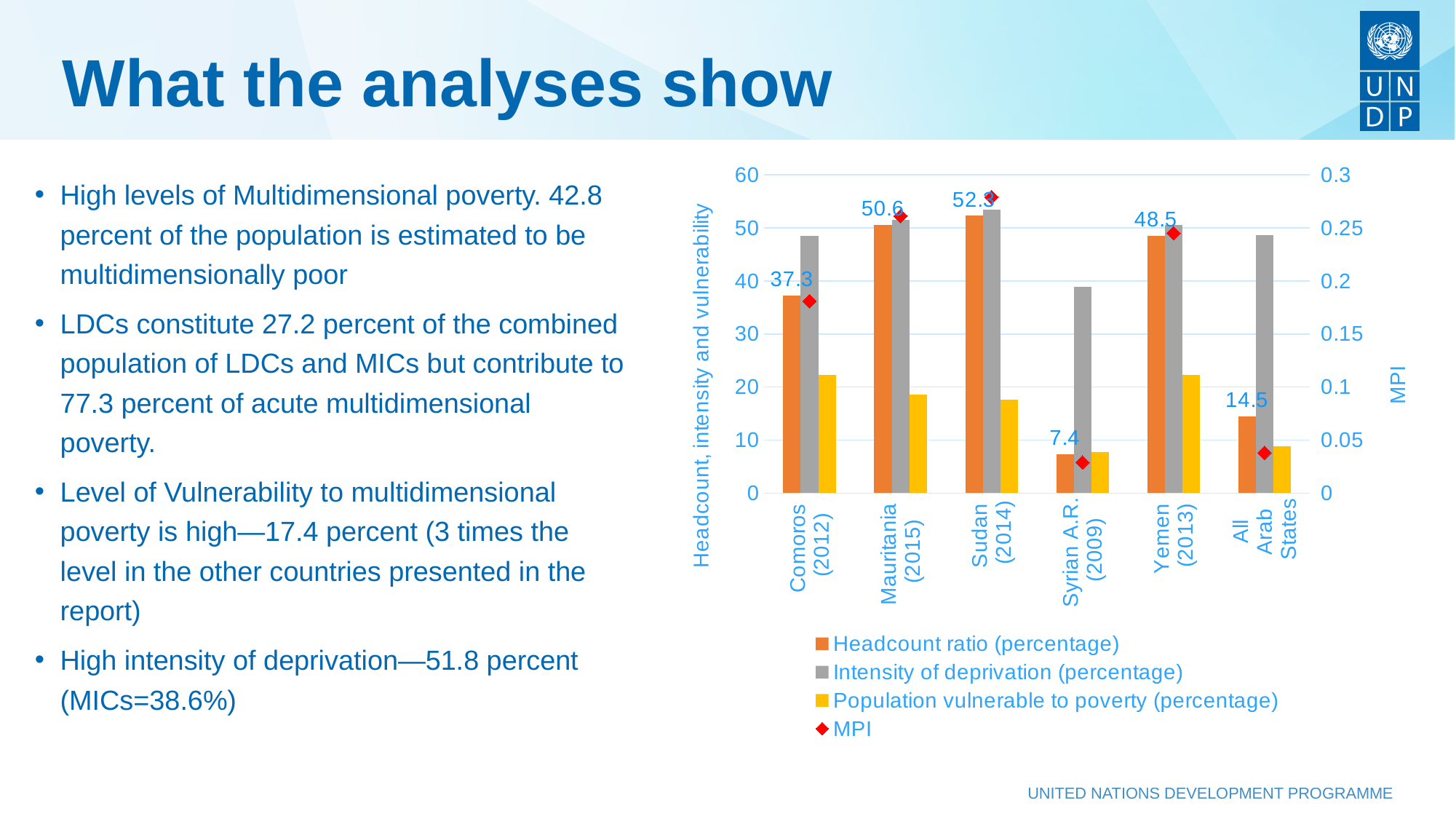
How many series does the chart legend list? 4 What is the headcount ratio (percentage) for Comoros (2012)? 37.3 Is the MPI value for Syrian A.R. (2009) greater or less than 0.05? less What is the headcount ratio (percentage) for Syrian A.R. (2009)? 7.4 Which has a larger headcount ratio, Yemen (2013) or Mauritania (2015)? Mauritania (2015) What is the headcount ratio (percentage) for All Arab States? 14.5 What is the difference between the headcount ratio for Mauritania (2015) and Comoros (2012)? 13.3 Which category has the highest headcount ratio (percentage)? Sudan (2014) Which category has the lowest headcount ratio (percentage)? Syrian A.R. (2009) Is the intensity of deprivation (percentage) for Syrian A.R. (2009) greater or less than 30? greater What is the headcount ratio (percentage) for Mauritania (2015)? 50.6 How many categories are shown on the x axis of the chart? 6